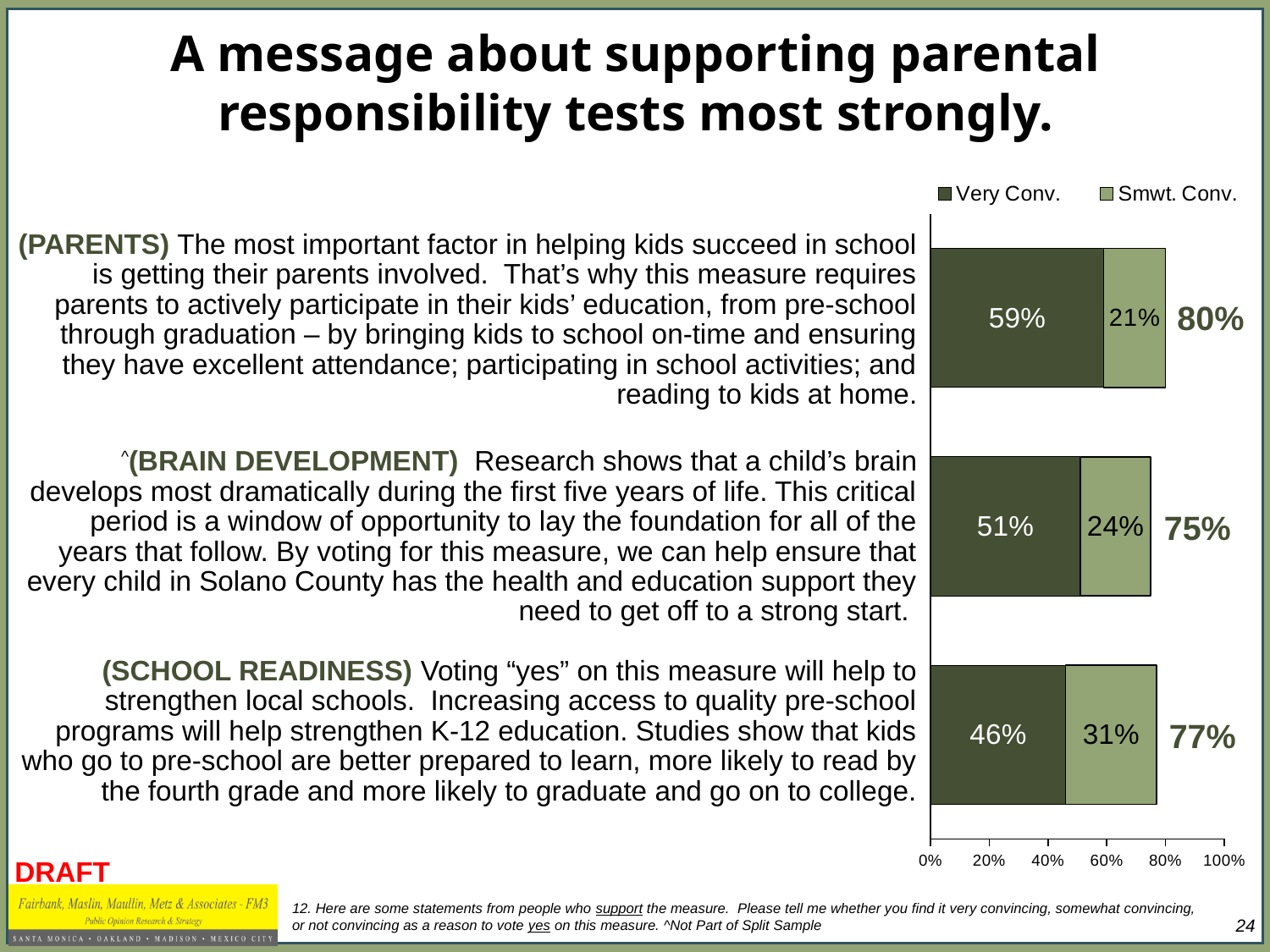
What is the total (very plus somewhat convincing) for the PARENTS message? 80% Which message has the lowest 'Very Conv.' percentage? SCHOOL READINESS Which message has the highest 'Very Conv.' percentage? PARENTS What percentage found the BRAIN DEVELOPMENT message somewhat convincing? 24% What is the difference between the 'Very Conv.' percentages for the PARENTS and SCHOOL READINESS messages? 13 percentage points What percentage found the SCHOOL READINESS message very convincing? 46% What is the total (very plus somewhat convincing) for the BRAIN DEVELOPMENT message? 75% How many messages are shown in the chart? 3 What percentage found the PARENTS message very convincing? 59% Which is larger: the 'Smwt. Conv.' share for SCHOOL READINESS or for PARENTS? SCHOOL READINESS How many series does the legend list? 2 What type of chart is shown on the slide? Stacked bar chart